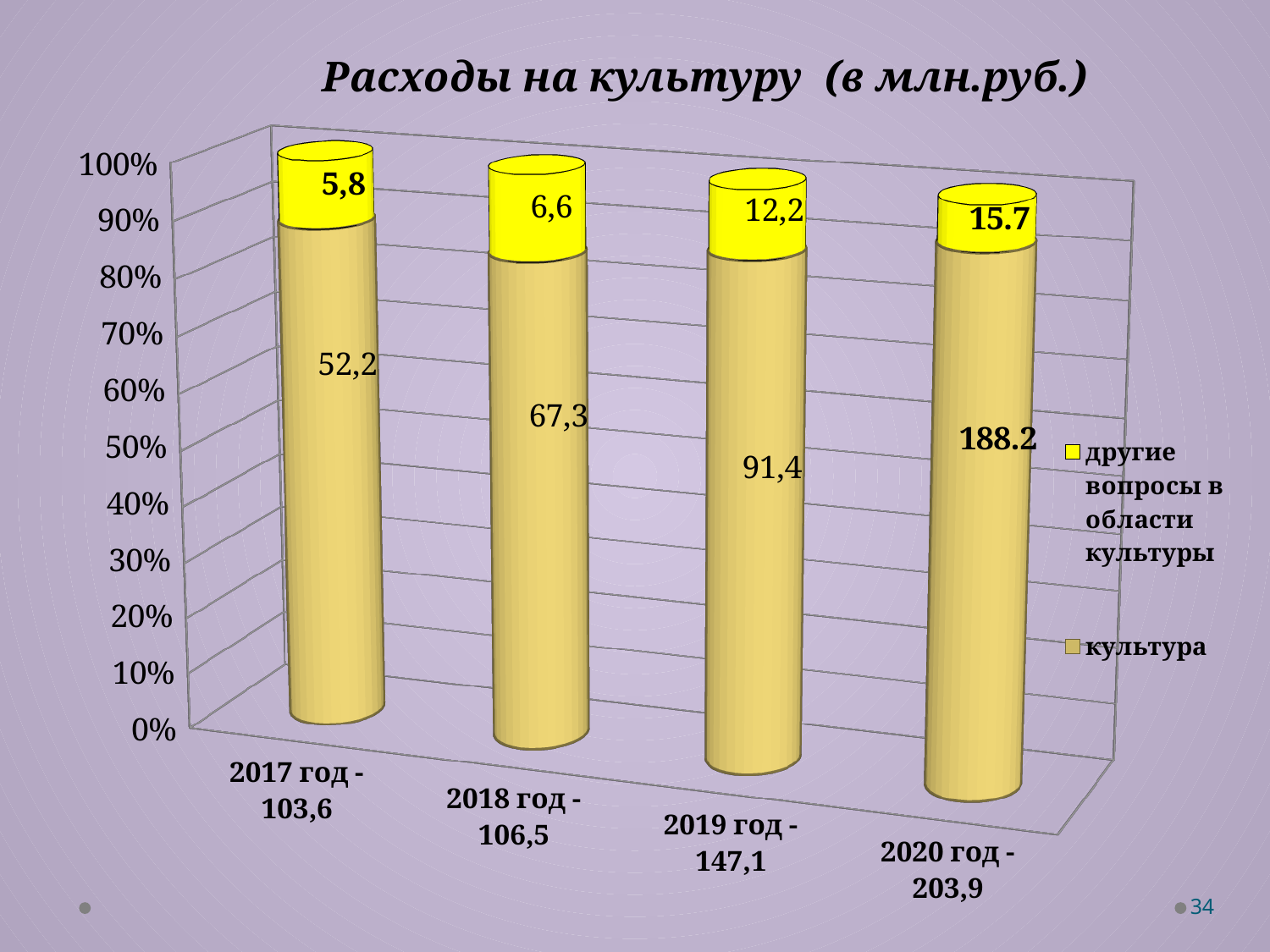
What kind of chart is shown on the slide? Stacked bar chart Which is larger: the 'другие вопросы в области культуры' value for 2019 год or for 2020 год? 2020 год What is the value of the 'другие вопросы в области культуры' series for 2019 год? 12,2 How many series does the legend list? 2 What is the value of the 'другие вопросы в области культуры' series for 2018 год? 6,6 What is the difference between the 'культура' values for 2019 год and 2018 год? 24,1 How many years (categories) are shown on the chart? 4 What is the value of the 'культура' series for 2017 год? 52,2 In which year is the 'культура' value the highest? 2020 год What is the value of the 'культура' series for 2020 год? 188.2 What is the title of the chart? Расходы на культуру (в млн.руб.) In which year is the 'другие вопросы в области культуры' value the lowest? 2017 год